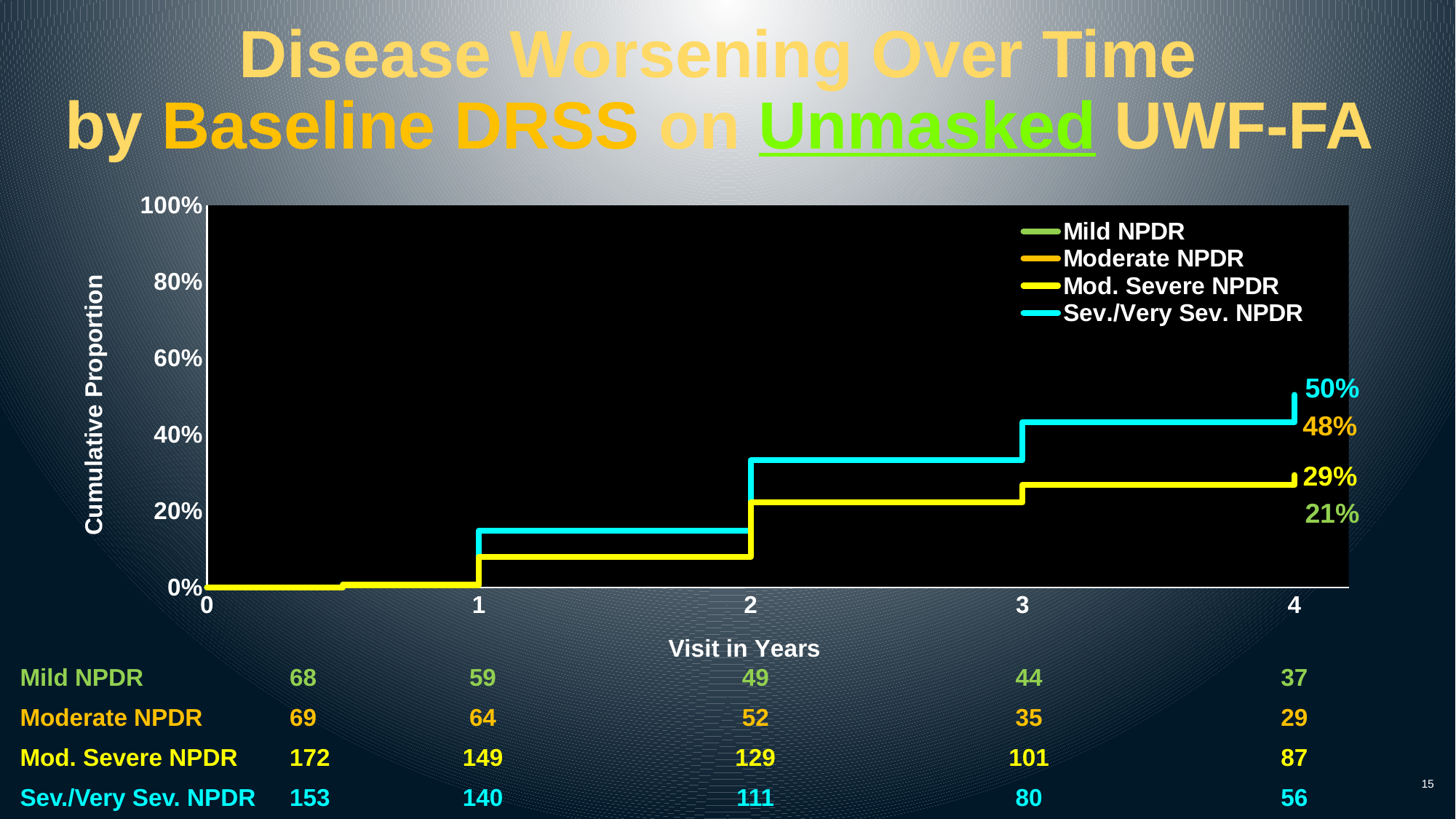
Which series has the lowest cumulative proportion at year 4? Mild NPDR What is the cumulative proportion labelled for Mild NPDR at year 4? 21% What is the cumulative proportion labelled for Moderate NPDR at year 4? 48% What is the cumulative proportion for Mod. Severe NPDR at year 4? 29% What is the cumulative proportion for Sev./Very Sev. NPDR at year 4? 50% Which series has the highest cumulative proportion at year 4? Sev./Very Sev. NPDR What kind of chart is shown on the slide? line chart What is the title of the x axis? Visit in Years Does the cumulative proportion for Sev./Very Sev. NPDR rise or fall over the years? rise What is the difference between the year-4 values for Sev./Very Sev. NPDR and Mod. Severe NPDR? 21 percentage points How many series does the legend list? 4